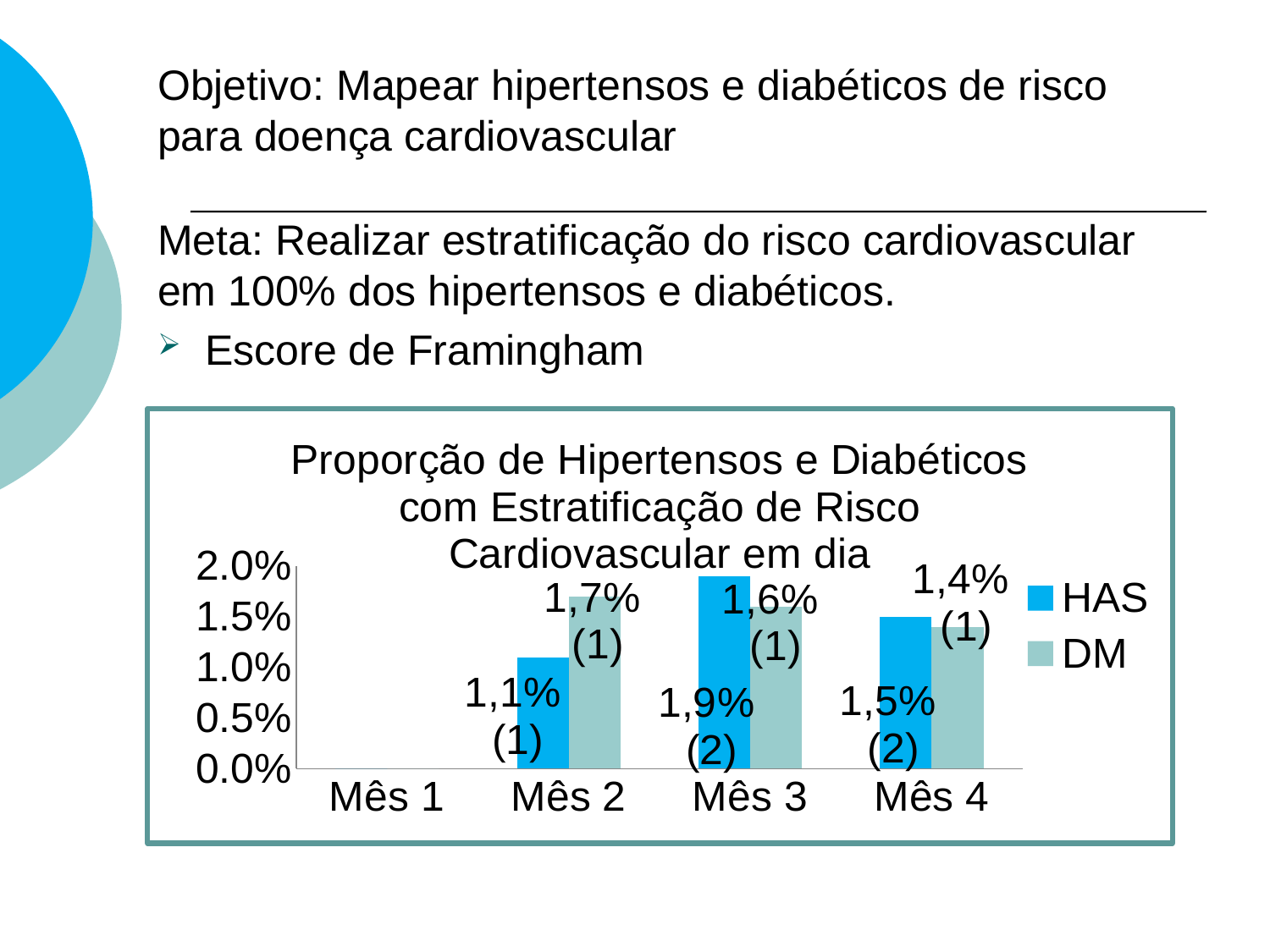
What is the difference between the DM and HAS values in Mês 2? 0,6% Among Mês 2, Mês 3 and Mês 4, which month has the lowest DM value? Mês 4 How many months are shown on the x axis? 4 In Mês 2, which series has the larger value, HAS or DM? DM What is the HAS value for Mês 3? 1,9% Does the HAS value rise or fall from Mês 2 to Mês 3? Rise What kind of chart is shown on the slide? Bar chart Which month has the highest HAS value? Mês 3 What is the DM value for Mês 4? 1,4% What is the HAS value for Mês 2? 1,1% What is the DM value for Mês 2? 1,7% How many series does the legend list? 2